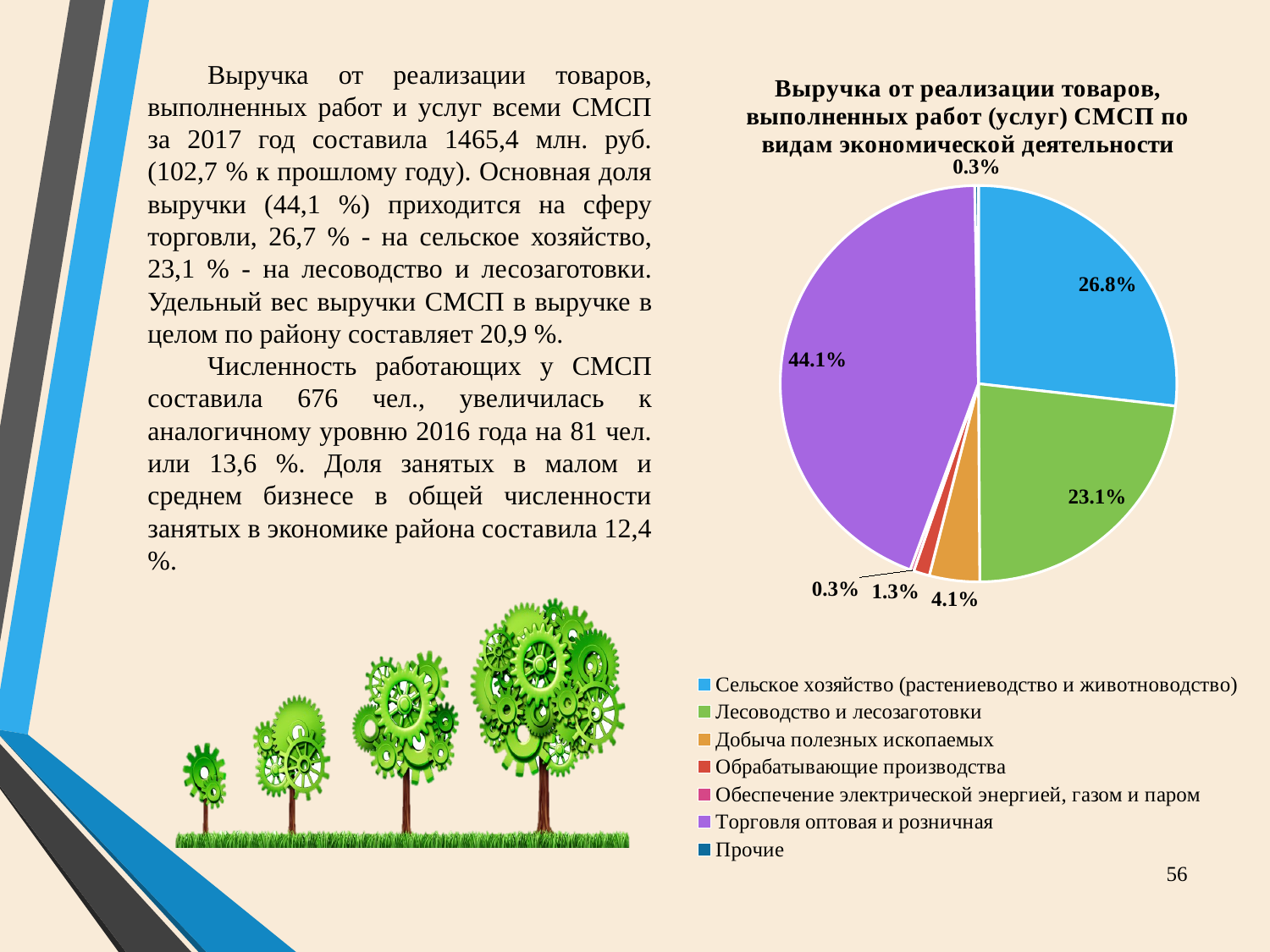
How many categories does the legend of the pie chart list? 7 What share of the pie does Добыча полезных ископаемых have? 4.1% What share of the pie does Лесоводство и лесозаготовки have? 23.1% What is the difference in percentage points between the share for Торговля оптовая и розничная and the share for Сельское хозяйство? 17.3 Which category has the largest share of the pie? Торговля оптовая и розничная Which is larger: the share for Сельское хозяйство or the share for Лесоводство и лесозаготовки? Сельское хозяйство What is the title of the pie chart? Выручка от реализации товаров, выполненных работ (услуг) СМСП по видам экономической деятельности What share of the pie does Сельское хозяйство (растениеводство и животноводство) have? 26.8% What colour is the slice for Лесоводство и лесозаготовки? green What share of the pie does Обрабатывающие производства have? 1.3% What type of chart is shown on the slide? pie chart What share of the pie does Торговля оптовая и розничная have? 44.1%